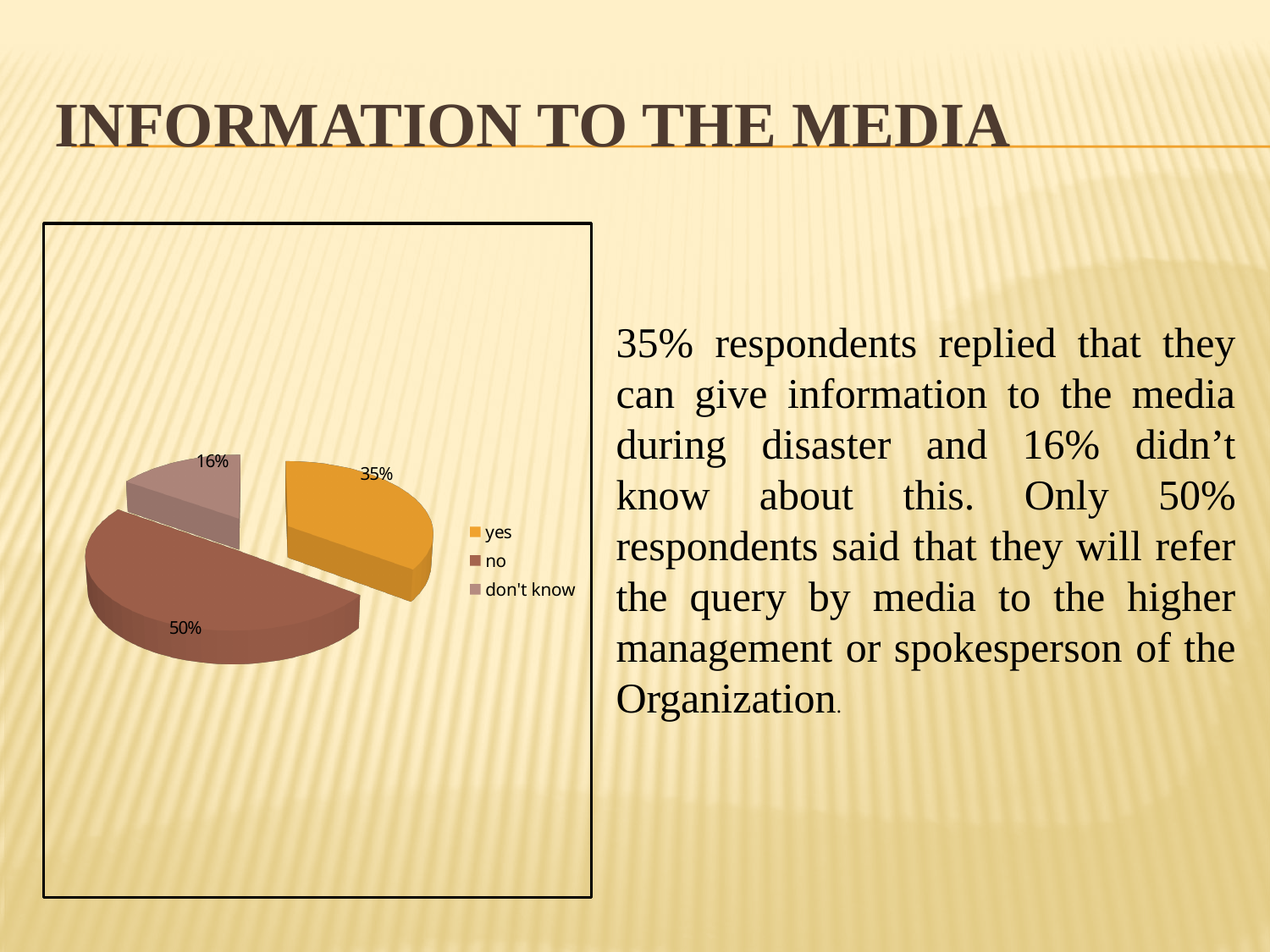
Which category has the smallest share of the pie? don't know What percentage of respondents answered "yes"? 35% Which is larger, the "yes" slice or the "don't know" slice? yes How many entries does the legend list? 3 How many categories does the pie chart show? 3 What is the difference in percentage points between the "no" and "yes" slices? 15 What colour is the "no" slice in the pie chart? brown What percentage of respondents answered "don't know"? 16% What is the difference in percentage points between the "yes" and "don't know" slices? 19 Which category has the largest share of the pie? no What kind of chart is shown on the slide? pie chart What percentage of respondents answered "no"? 50%